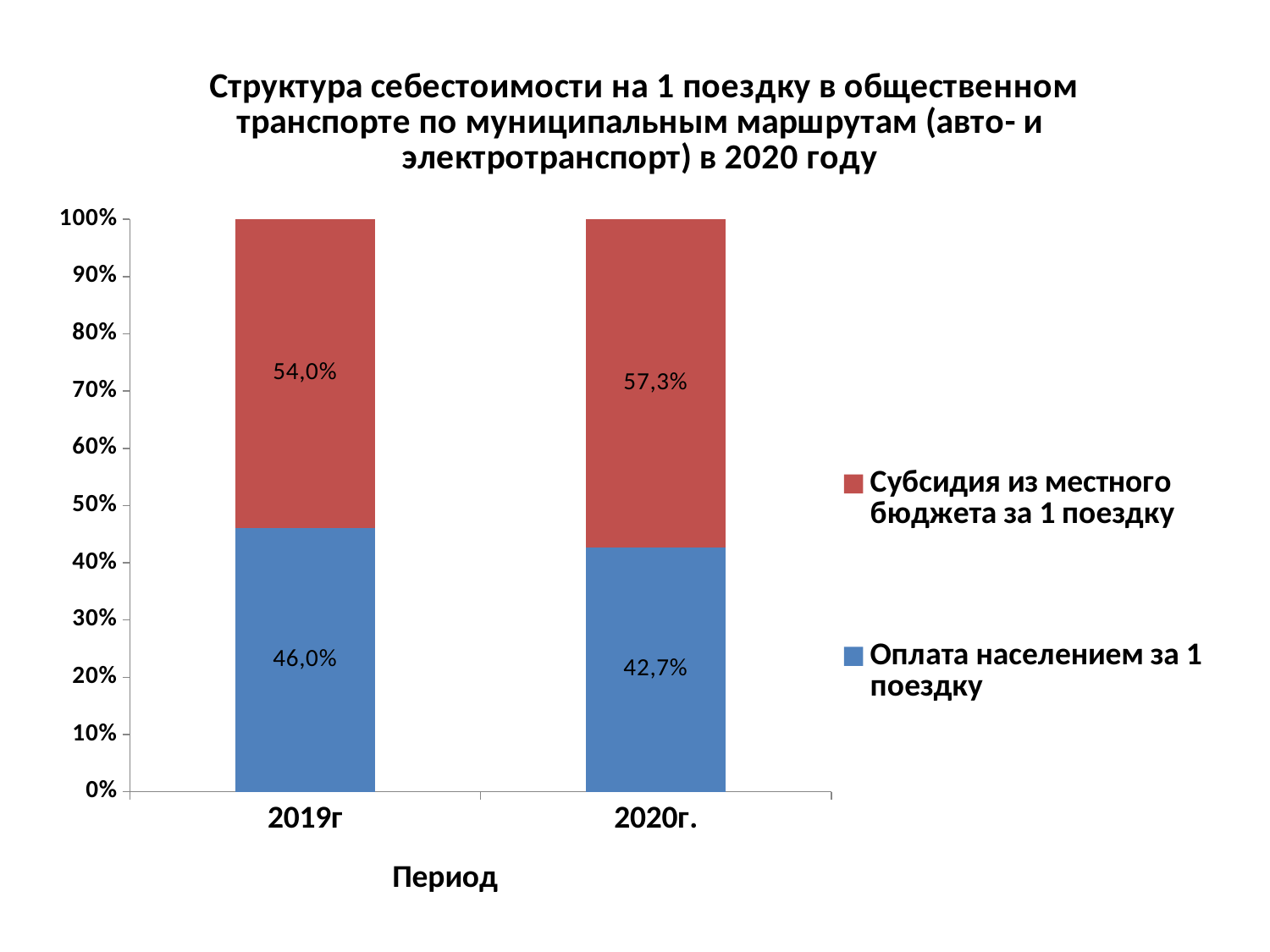
Does the share of 'Оплата населением за 1 поездку' rise or fall from 2019г to 2020г.? Fall Which period has the lower value for 'Оплата населением за 1 поездку'? 2020г. What is the difference between the 'Субсидия из местного бюджета за 1 поездку' values for 2020г. and 2019г? 3,3% How many periods are shown on the x axis? 2 What kind of chart is shown on the slide? Stacked bar chart What is the value for 'Оплата населением за 1 поездку' in 2020г.? 42,7% What is the value for 'Оплата населением за 1 поездку' in 2019г? 46,0% In 2019г, which is larger: 'Субсидия из местного бюджета за 1 поездку' or 'Оплата населением за 1 поездку'? Субсидия из местного бюджета за 1 поездку How many series does the legend list? 2 What is the value for 'Субсидия из местного бюджета за 1 поездку' in 2019г? 54,0% Which period has the higher value for 'Субсидия из местного бюджета за 1 поездку'? 2020г. What is the value for 'Субсидия из местного бюджета за 1 поездку' in 2020г.? 57,3%